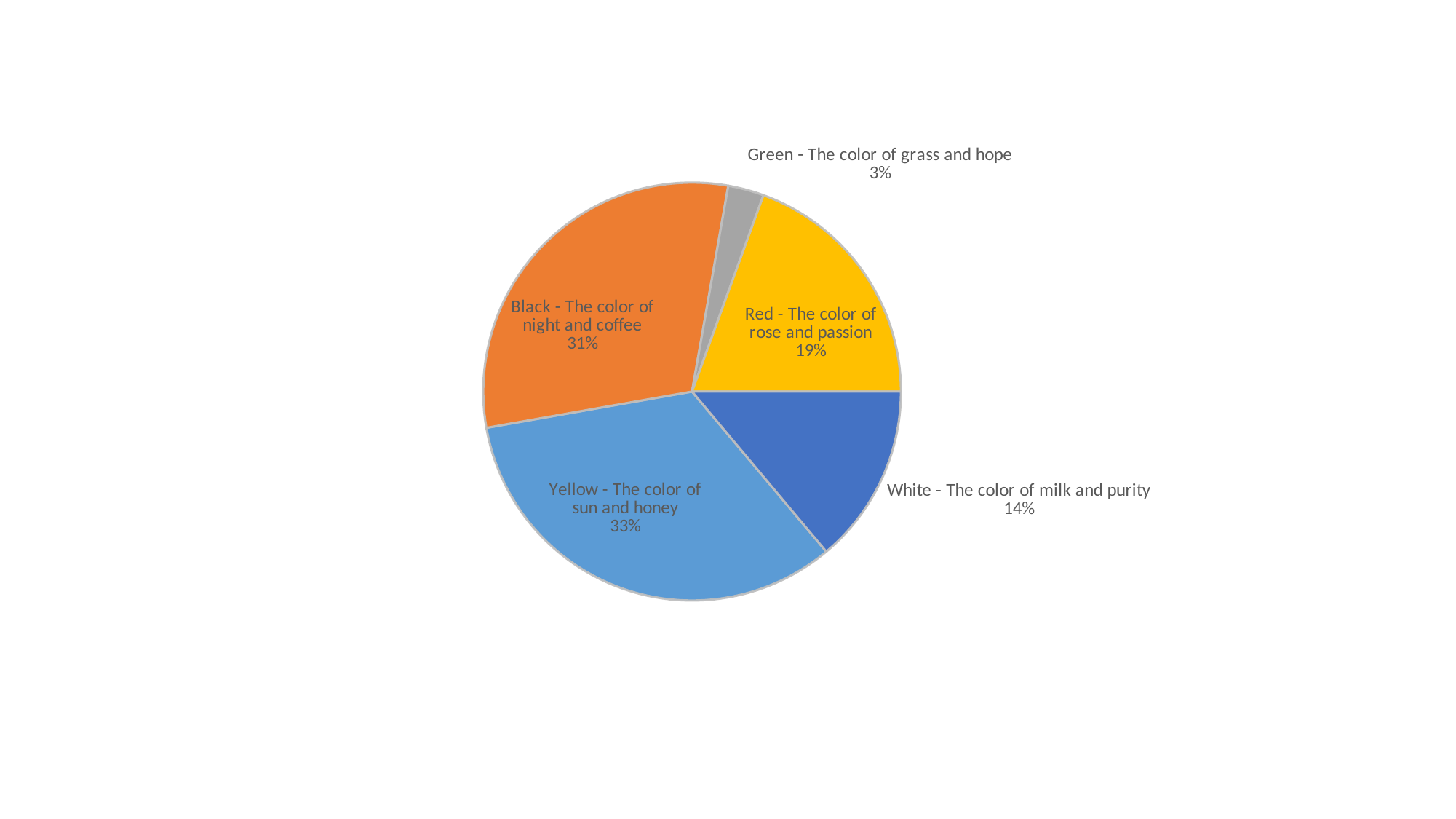
What share of the pie is labelled "Red - The color of rose and passion"? 19% What share of the pie is labelled "Black - The color of night and coffee"? 31% Which slice has the largest share of the pie? Yellow - The color of sun and honey Which slice has the smallest share of the pie? Green - The color of grass and hope What kind of chart is shown on the slide? Pie chart What share of the pie is labelled "White - The color of milk and purity"? 14% How many slices does the pie chart have? 5 What colour is the slice labelled "White - The color of milk and purity" drawn in? Dark blue Which is larger, the share for Black or the share for Red? Black - The color of night and coffee What is the difference in percentage points between the Red slice and the White slice? 5